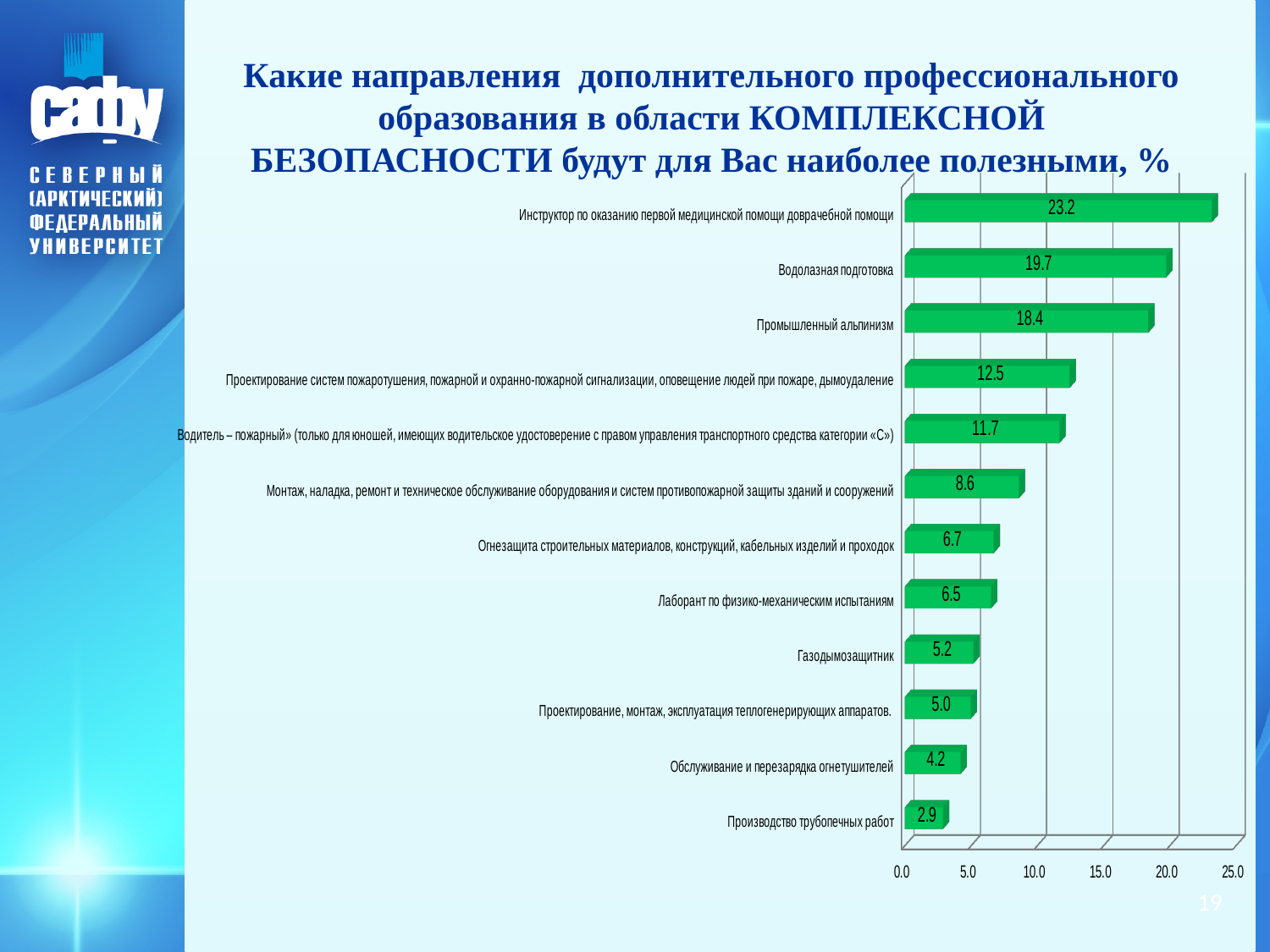
What is the difference between the values for Водолазная подготовка and Промышленный альпинизм? 1.3 What is the value for Газодымозащитник? 5.2 What kind of chart is shown on the slide? Bar chart What is the value for Обслуживание и перезарядка огнетушителей? 4.2 What is the difference between the values for Инструктор по оказанию первой медицинской помощи доврачебной помощи and Производство трубопечных работ? 20.3 Which category has the highest value? Инструктор по оказанию первой медицинской помощи доврачебной помощи Which is larger: the value for Лаборант по физико-механическим испытаниям or the value for Газодымозащитник? Лаборант по физико-механическим испытаниям How many categories are shown in the chart? 12 Which category has the lowest value? Производство трубопечных работ Is the value for Водитель – пожарный greater or less than 10.0? greater What is the value for Водолазная подготовка? 19.7 What is the value for Промышленный альпинизм? 18.4